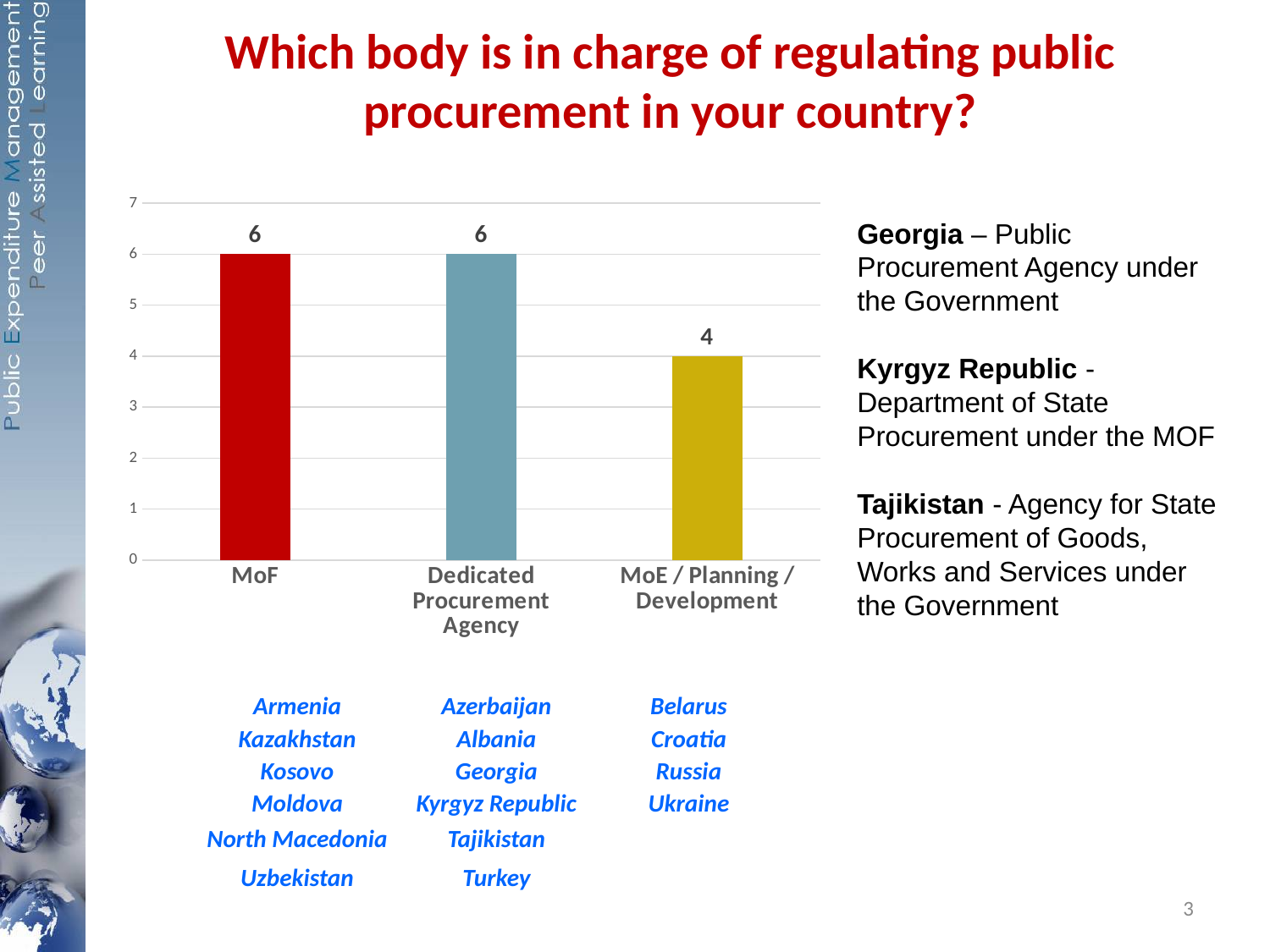
Which is larger, the value for Dedicated Procurement Agency or the value for MoE / Planning / Development? Dedicated Procurement Agency What colour is the bar for MoF? red What is the difference between the values for MoF and MoE / Planning / Development? 2 What is the value for MoF? 6 What is the highest value shown on the vertical axis? 7 What is the total of the values across all three categories? 16 What is the value for MoE / Planning / Development? 4 What is the value for Dedicated Procurement Agency? 6 Is the value for MoE / Planning / Development greater or less than 5? less Which category has the lowest value? MoE / Planning / Development How many categories are shown on the chart? 3 What kind of chart is shown on the slide? bar chart